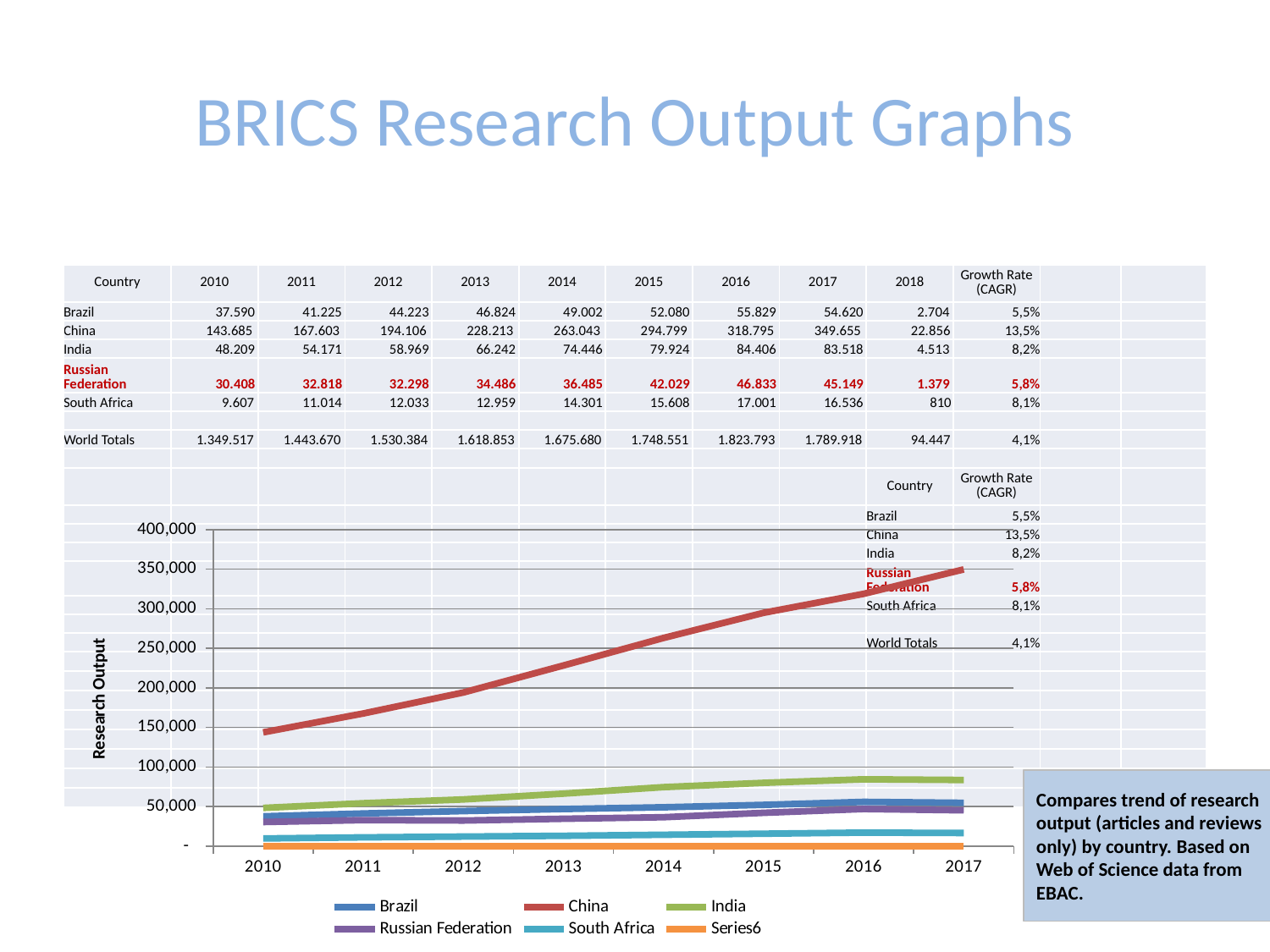
Which series has the highest research output in 2017? China What is the title of the chart's y axis? Research Output How many years are shown along the x axis of the chart? 8 Which country's line is the lowest in 2017? South Africa Is the value for China in 2010 greater or less than 100,000? greater Is the value for Brazil in 2010 greater or less than 50,000? less Does China's research output rise or fall from 2010 to 2017? rises How many series does the chart's legend list? 6 Is the value for India in 2017 greater or less than 100,000? less What kind of chart is shown on the slide? line chart Which is larger in 2015, the value for China or the value for India? China